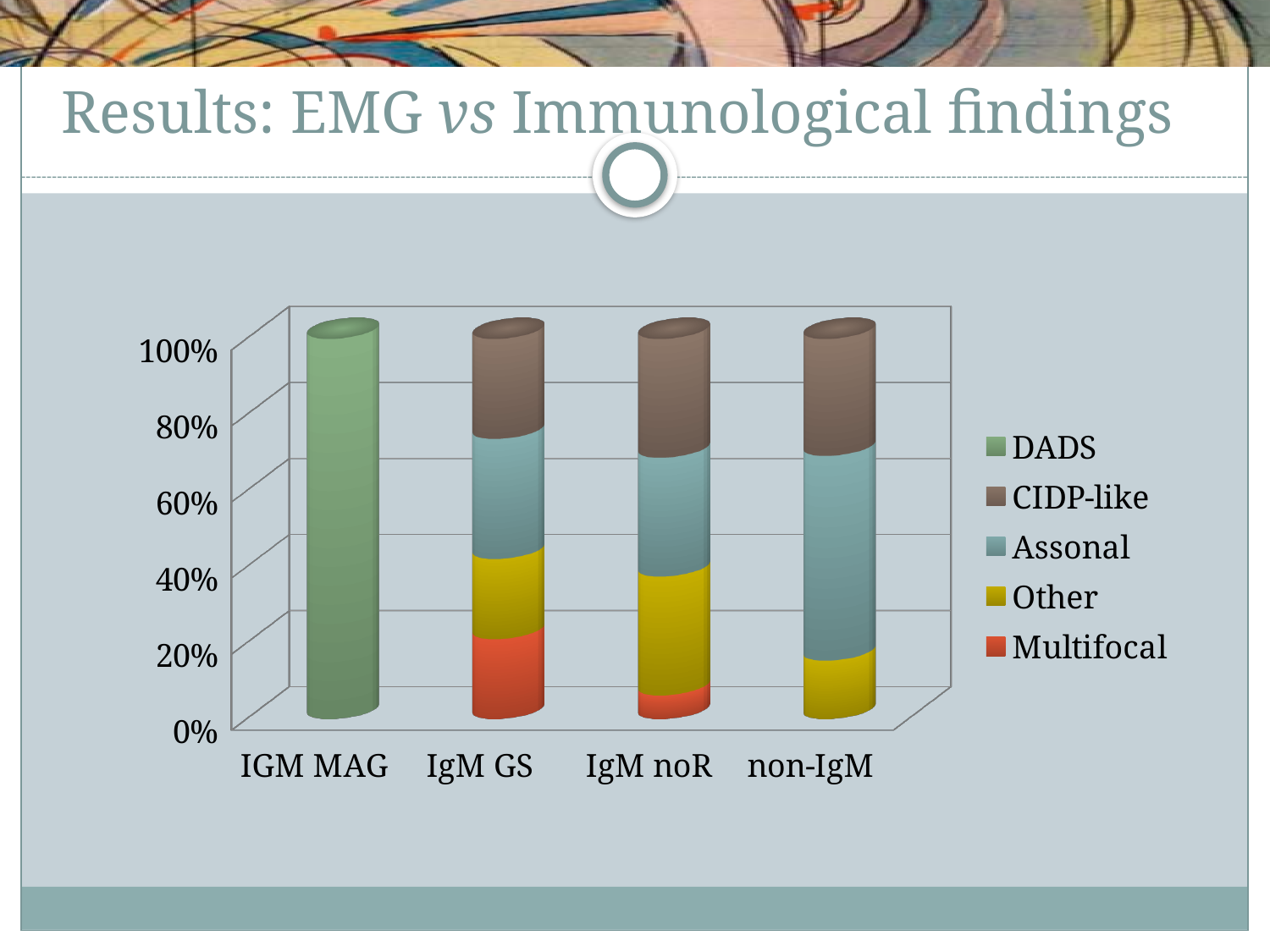
Is the Assonal share for non-IgM greater or less than 40%? greater What share of the IGM MAG bar is DADS? 100% Is the Multifocal share for IgM noR greater or less than 20%? less How many series does the chart's legend list? 5 What is the title of the slide containing the chart? Results: EMG vs Immunological findings How many categories are shown on the x axis of the chart? 4 Is the Other share for IgM noR greater or less than 20%? greater Which category has the largest Assonal share? non-IgM Which has the larger Multifocal share, IgM GS or IgM noR? IgM GS What kind of chart is shown on the slide? stacked bar chart Which has the larger Assonal share, IgM GS or non-IgM? non-IgM Which category's bar is made up entirely of DADS? IGM MAG